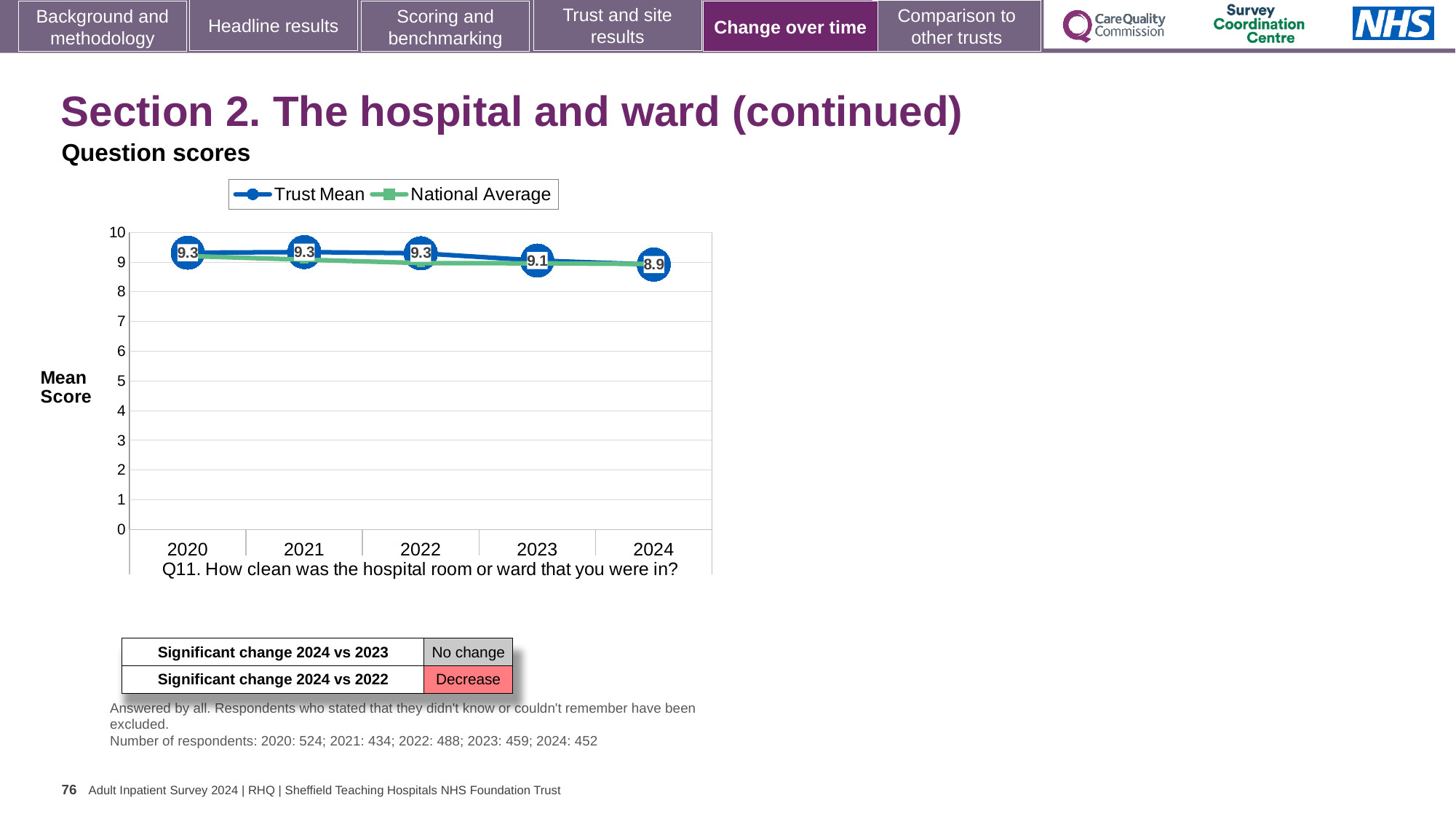
How many series does the legend list? 2 Does the Trust Mean rise or fall from 2020 to 2024? Fall What is the Trust Mean score for 2023? 9.1 What question is the chart about, as shown below the x axis? Q11. How clean was the hospital room or ward that you were in? Is the Trust Mean value for 2024 greater or less than 9? less What is the difference between the Trust Mean score in 2022 and in 2024? 0.4 What kind of chart is shown on the slide? Line chart What is the Trust Mean score for 2024? 8.9 Which is larger, the Trust Mean score for 2023 or for 2024? 2023 What is the Trust Mean score for 2020? 9.3 How many years are shown on the x axis? 5 Which year has the lowest Trust Mean score? 2024